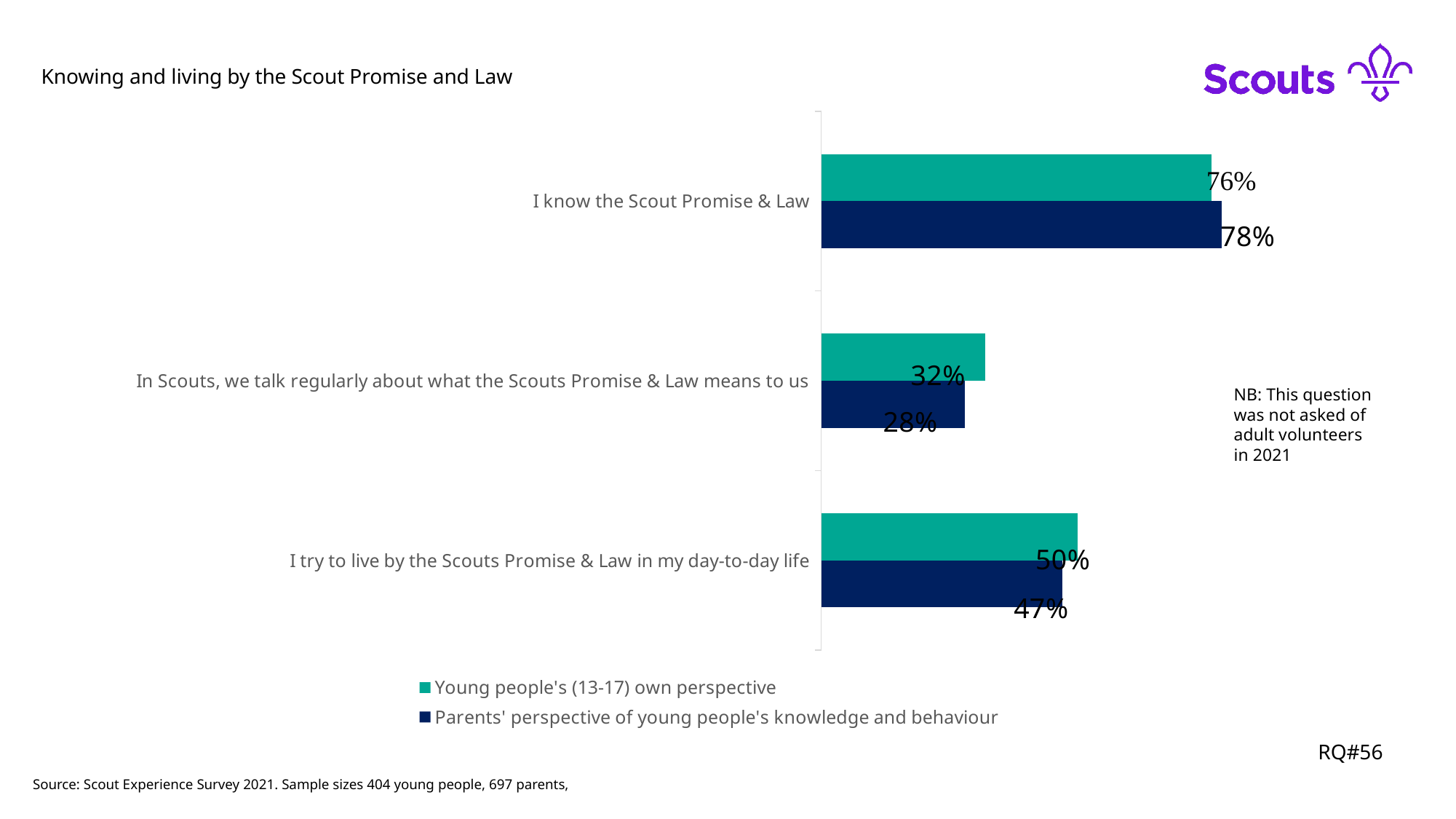
What is the title of the chart? Knowing and living by the Scout Promise and Law What is the parents' perspective value for 'I try to live by the Scouts Promise & Law in my day-to-day life'? 47% How many series does the legend list? 2 For 'I try to live by the Scouts Promise & Law in my day-to-day life', which is larger: the young people's value or the parents' value? Young people's (13-17) own perspective What percentage of young people say that in Scouts they talk regularly about what the Scouts Promise & Law means to them? 32% How many statements (categories) are shown on the chart? 3 Which statement has the highest value from young people's own perspective? I know the Scout Promise & Law Which statement has the lowest value from the parents' perspective? In Scouts, we talk regularly about what the Scouts Promise & Law means to us What is the difference between the young people's and parents' values for 'In Scouts, we talk regularly about what the Scouts Promise & Law means to us'? 4 percentage points What is the parents' perspective value for 'I know the Scout Promise & Law'? 78% What percentage of young people (13-17) say they know the Scout Promise & Law? 76% What kind of chart is shown on the slide? Bar chart